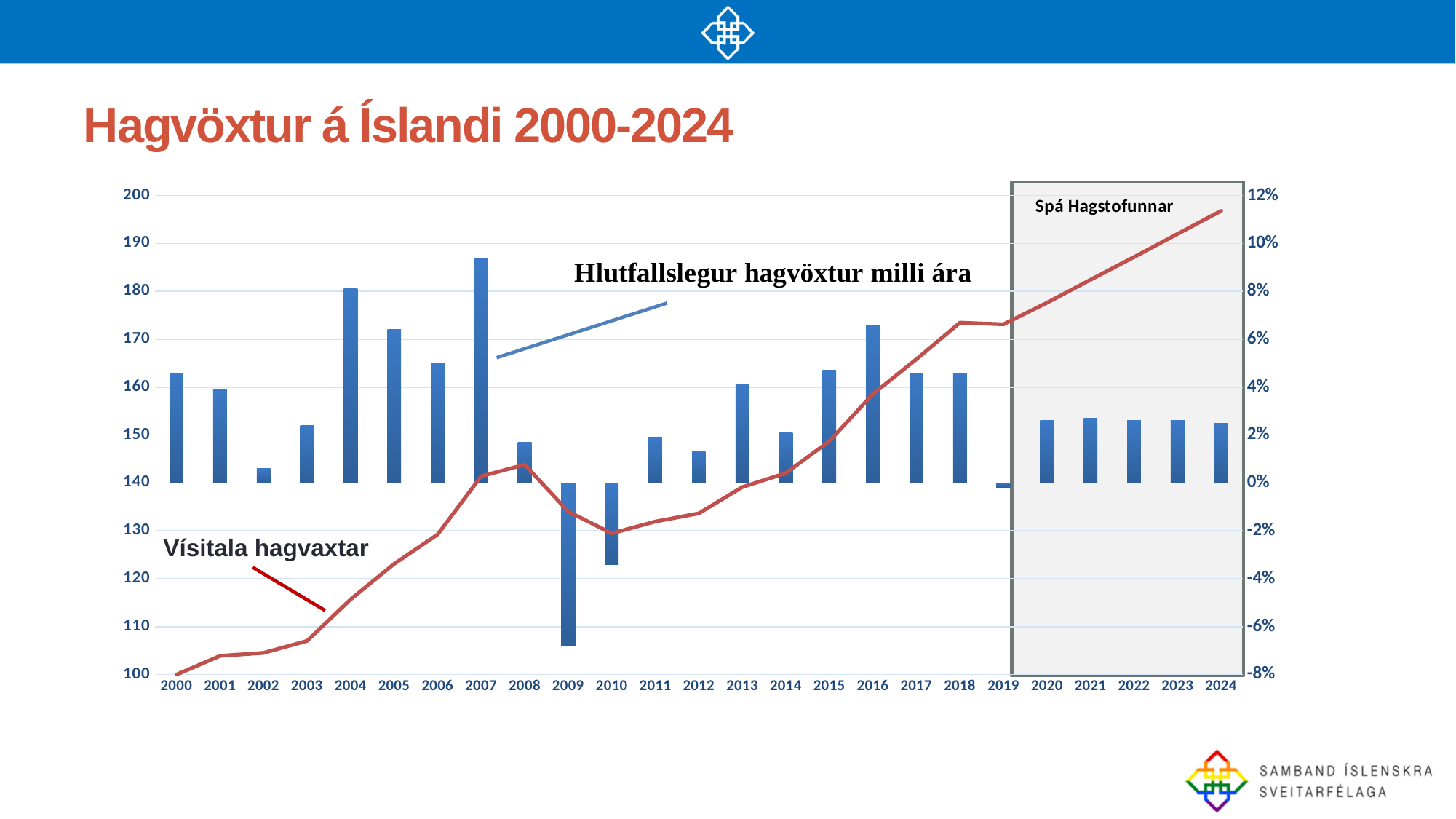
Is the bar value for 2009 greater or less than -6%? less Does the Vísitala hagvaxtar line rise or fall overall from 2000 to 2024? rise What is the title of the chart on the slide? Hagvöxtur á Íslandi 2000-2024 What kind of chart is shown on the slide? Combined bar and line chart Is the Vísitala hagvaxtar line value for 2024 greater or less than 190? greater In which year is the bar for Hlutfallslegur hagvöxtur milli ára the lowest? 2009 Is the bar value for 2007 greater or less than 8%? greater In which year is the bar for Hlutfallslegur hagvöxtur milli ára the highest? 2007 How many years are shown along the x axis of the chart? 25 What label is shown in the shaded area covering 2020 to 2024? Spá Hagstofunnar Which year has the larger bar, 2004 or 2005? 2004